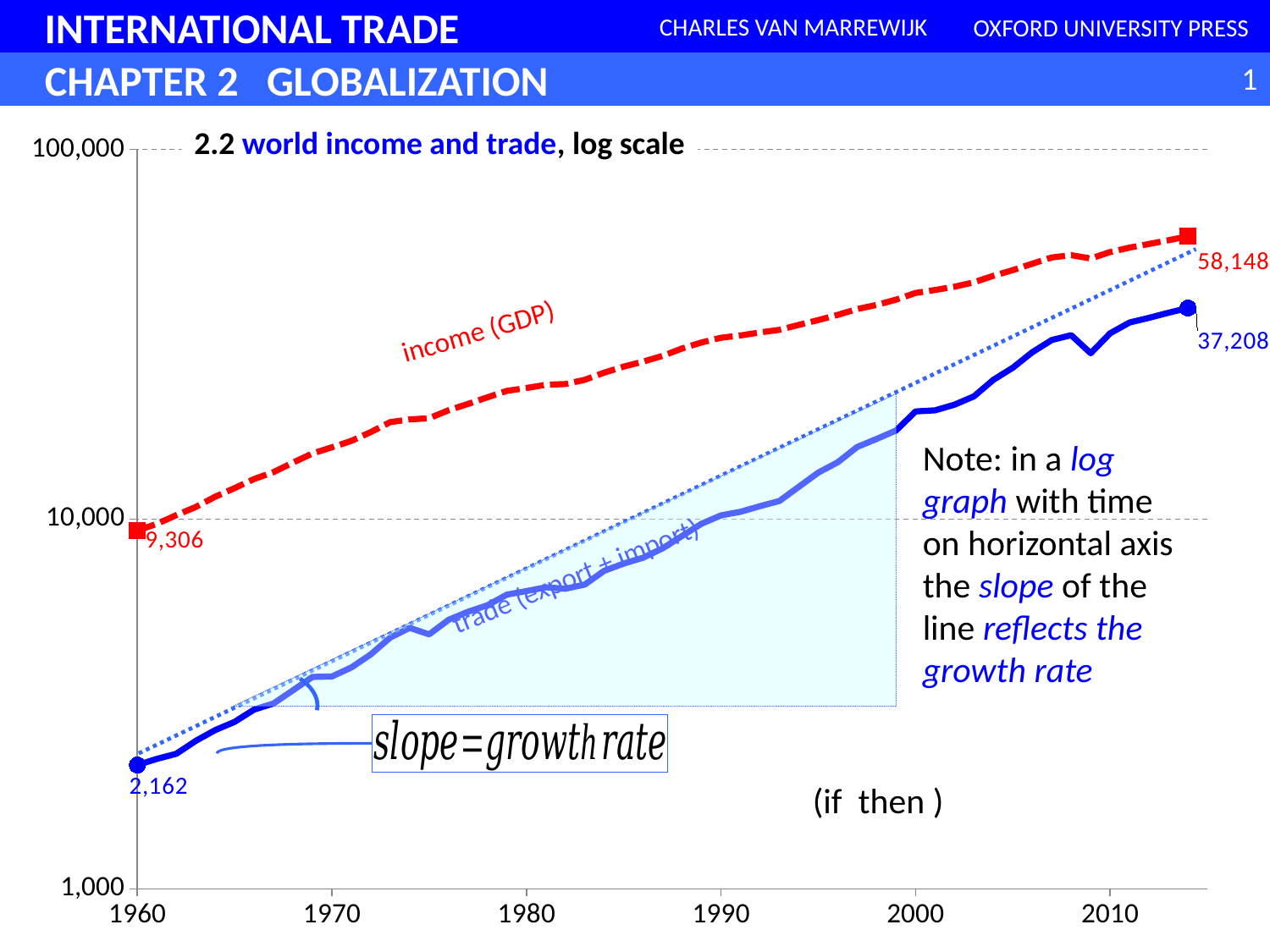
Is the value of income (GDP) in 1980 greater or less than 10,000? greater In 1960, which is larger: income (GDP) or trade (export + import)? income (GDP) What is the difference between the final labelled values of income (GDP) and trade (export + import)? 20,940 What is the final labelled value of the income (GDP) series? 58,148 What kind of chart is shown on the slide? line chart What is the final labelled value of the trade (export + import) series? 37,208 Which series is drawn as a red dashed line? income (GDP) What is the value of income (GDP) in 1960? 9,306 Is the value of trade (export + import) in 1980 greater or less than 10,000? less Do the income (GDP) and trade series rise or fall over time from 1960 onward? rise What is the value of trade (export + import) in 1960? 2,162 By how much did income (GDP) increase from its 1960 value of 9,306 to its final labelled value of 58,148? 48,842